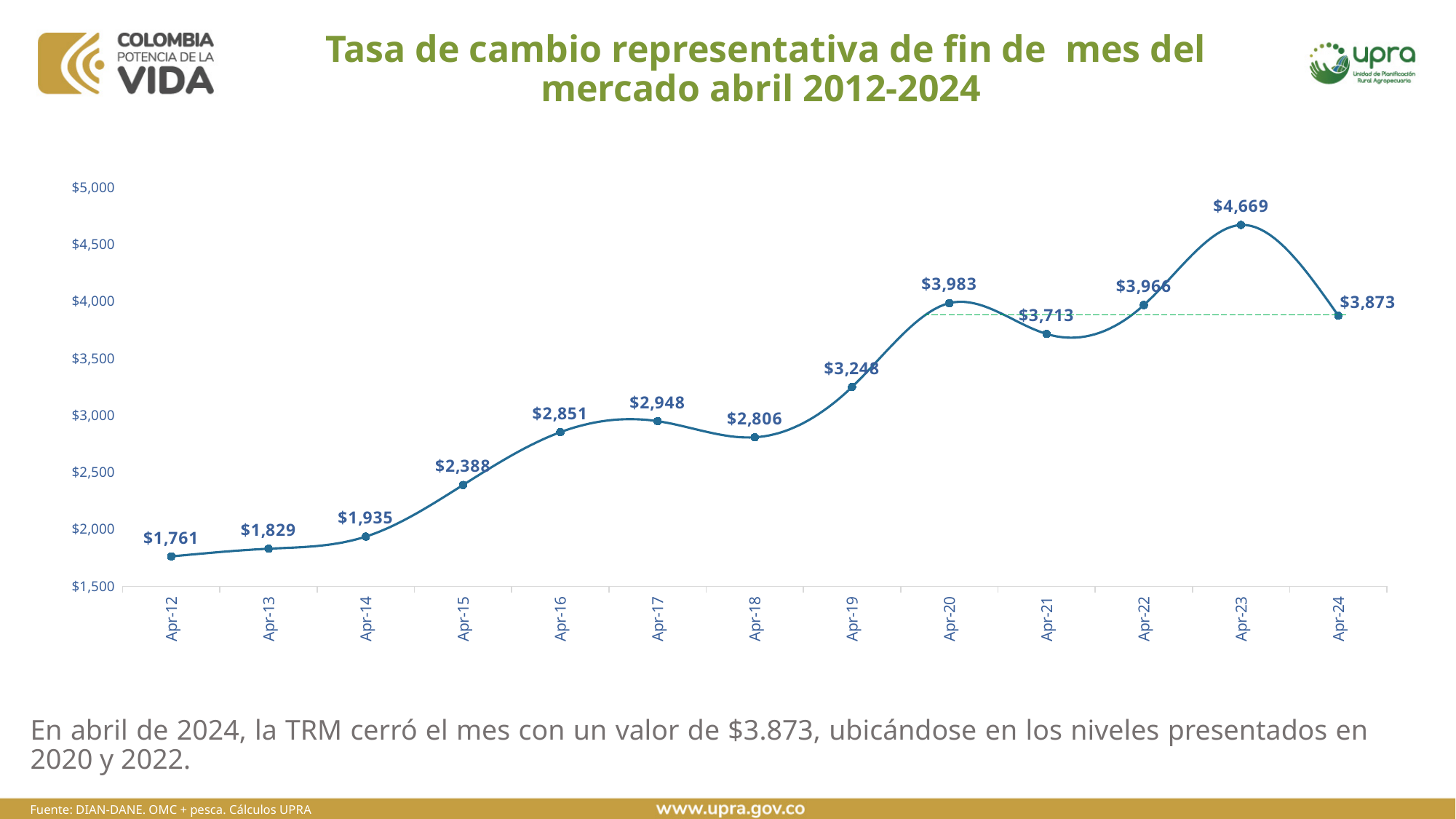
What is the value for Apr-19? $3,248 Which is larger, the value for Apr-20 or the value for Apr-22? Apr-20 Which point has the highest value? Apr-23 What is the value for Apr-12? $1,761 Is the value for Apr-21 greater or less than $4,000? less What is the difference between the values for Apr-23 and Apr-24? $796 Which point has the lowest value? Apr-12 How many data points are plotted on the chart? 13 Do the values rise or fall from Apr-12 to Apr-16? rise What is the title of the chart? Tasa de cambio representativa de fin de mes del mercado abril 2012-2024 What is the value for Apr-24? $3,873 What kind of chart is shown on the slide? line chart